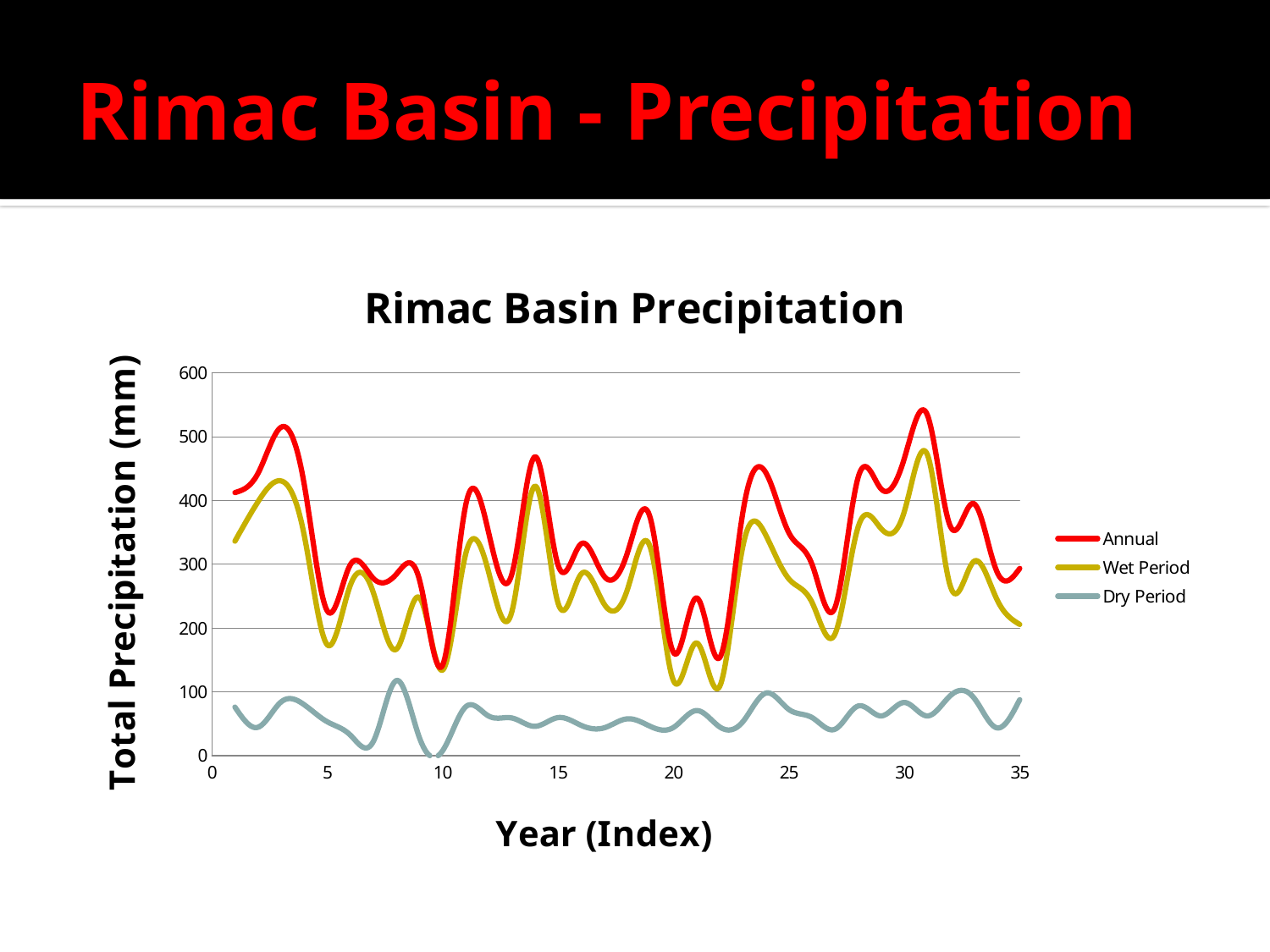
What is the label of the y axis? Total Precipitation (mm) Which series has the lowest values across the chart? Dry Period Is the Annual value at year 31 greater or less than 500? greater Is the Annual value at year 10 greater or less than 200? less At year 15, which is larger, the Annual value or the Dry Period value? Annual What is the title of the chart? Rimac Basin Precipitation Which series has the highest values across the chart? Annual Is the Wet Period value at year 20 greater or less than 200? less How many series does the legend list? 3 What kind of chart is shown on the slide? line chart